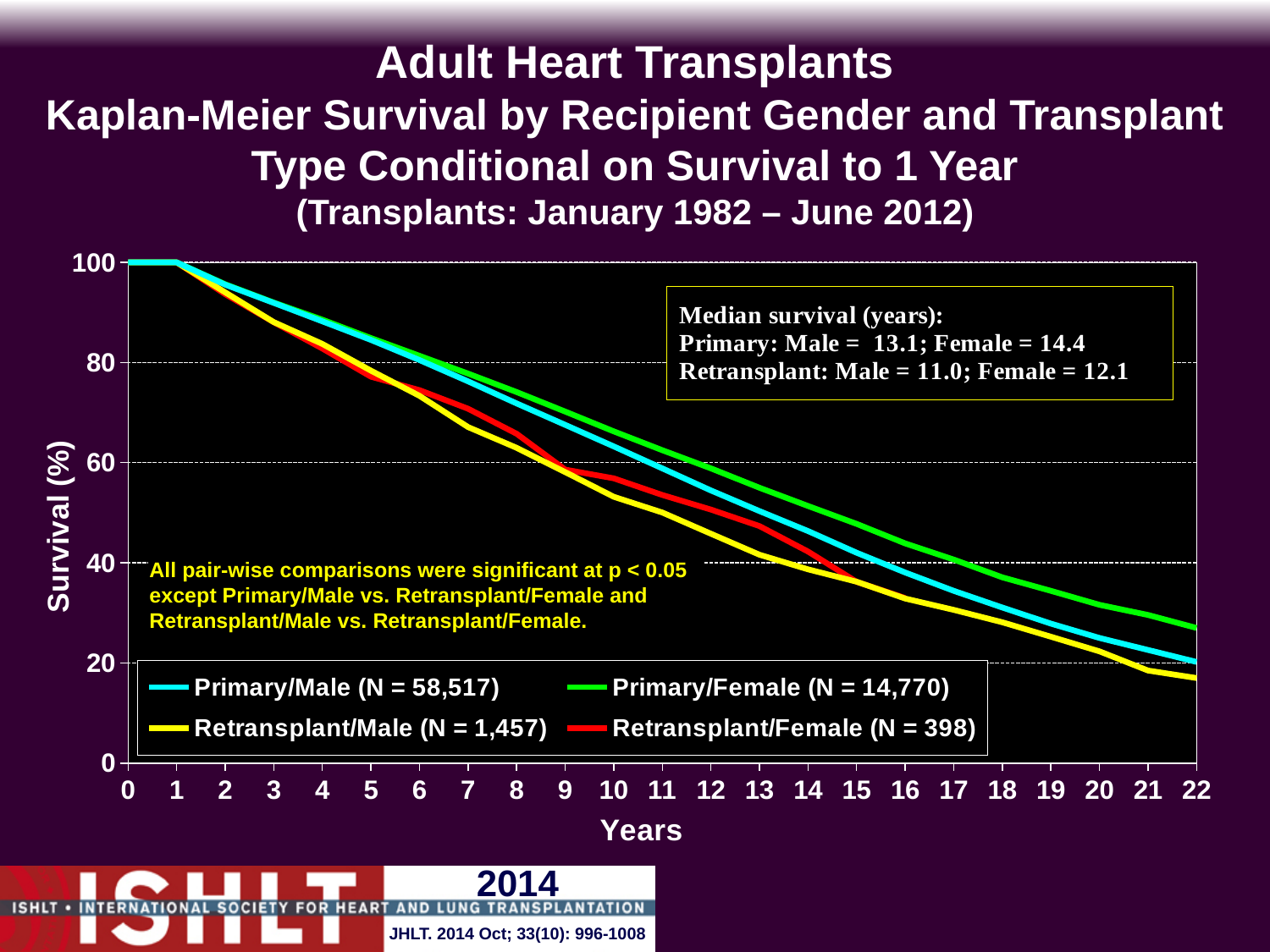
Is the survival for Primary/Female at 22 years greater or less than 20? greater What is the N for the Primary/Male group shown in the legend? 58,517 What is the difference in median survival (years) between Primary/Female and Primary/Male? 1.3 How many series does the legend list? 4 Which group has the lowest median survival? Retransplant/Male Which group has the highest median survival? Primary/Female What is the median survival in years for Retransplant/Male recipients? 11.0 What is the median survival in years for Primary/Female recipients? 14.4 Is the survival for Retransplant/Male at 10 years greater or less than 60? less What kind of chart is shown on the slide? line chart At 20 years, which curve is higher: Primary/Female or Retransplant/Male? Primary/Female Do the survival curves rise or fall as years increase? fall